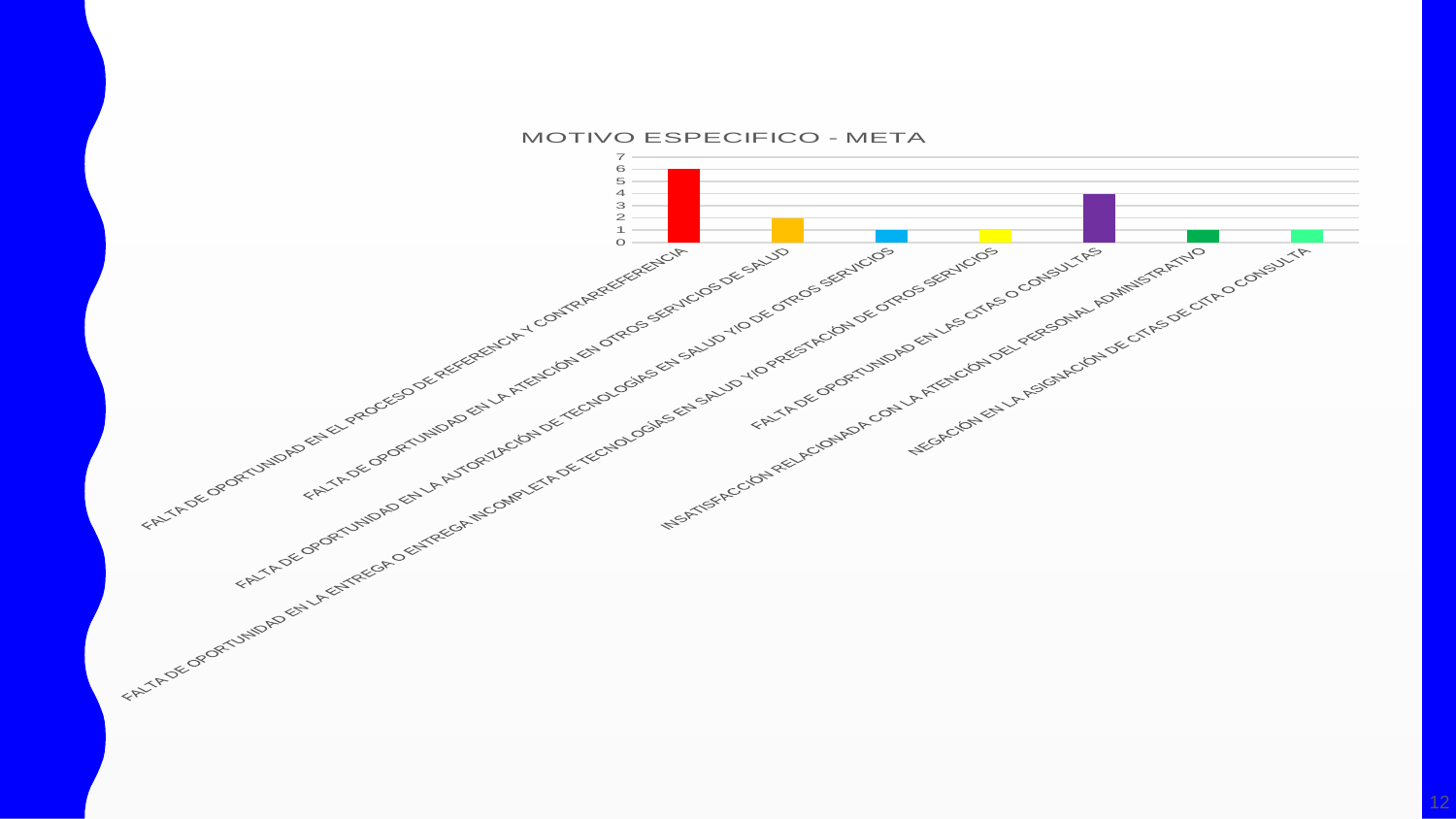
What is the difference between the value for FALTA DE OPORTUNIDAD EN EL PROCESO DE REFERENCIA Y CONTRARREFERENCIA and the value for FALTA DE OPORTUNIDAD EN LAS CITAS O CONSULTAS? 2 What kind of chart is shown on the slide? Bar chart Is the value for NEGACIÓN EN LA ASIGNACIÓN DE CITAS DE CITA O CONSULTA greater or less than 3? less What is the title of the chart? MOTIVO ESPECIFICO - META What is the value for FALTA DE OPORTUNIDAD EN LA ATENCIÓN EN OTROS SERVICIOS DE SALUD? 2 What is the value for FALTA DE OPORTUNIDAD EN EL PROCESO DE REFERENCIA Y CONTRARREFERENCIA? 6 Is the value for FALTA DE OPORTUNIDAD EN EL PROCESO DE REFERENCIA Y CONTRARREFERENCIA greater or less than 5? greater How many categories are plotted in the chart? 7 Which category has the highest value? FALTA DE OPORTUNIDAD EN EL PROCESO DE REFERENCIA Y CONTRARREFERENCIA What is the value for INSATISFACCIÓN RELACIONADA CON LA ATENCIÓN DEL PERSONAL ADMINISTRATIVO? 1 Which is larger, the value for FALTA DE OPORTUNIDAD EN LAS CITAS O CONSULTAS or the value for FALTA DE OPORTUNIDAD EN LA ATENCIÓN EN OTROS SERVICIOS DE SALUD? FALTA DE OPORTUNIDAD EN LAS CITAS O CONSULTAS What is the value for FALTA DE OPORTUNIDAD EN LAS CITAS O CONSULTAS? 4